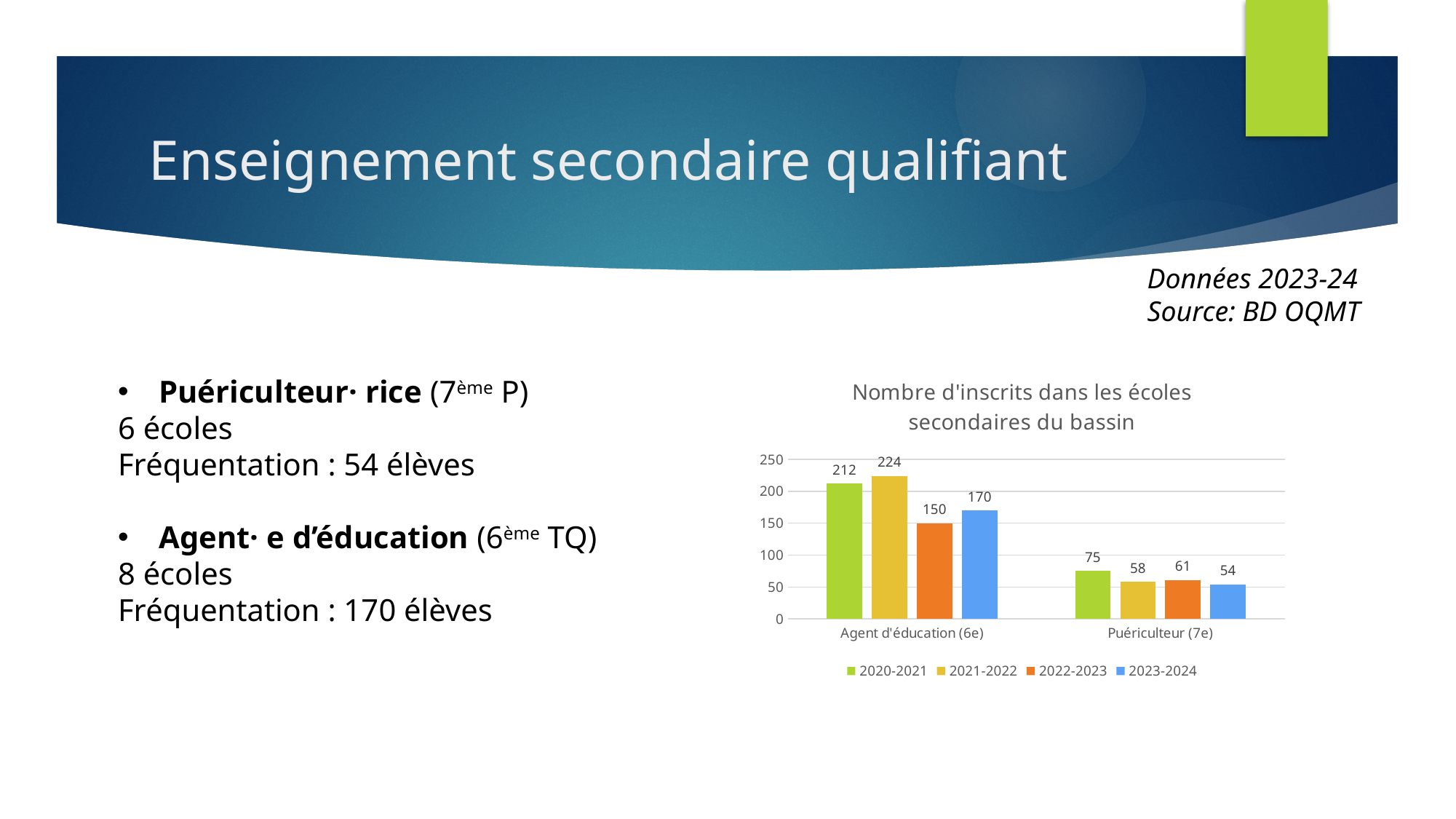
How many categories are shown on the x axis? 2 What is the difference between the 2021-2022 and 2022-2023 values for Agent d'éducation (6e)? 74 What is the value for Puériculteur (7e) in 2023-2024? 54 What is the value for Agent d'éducation (6e) in 2020-2021? 212 Which is larger for Puériculteur (7e): the 2021-2022 value or the 2022-2023 value? 2022-2023 Which year has the highest value for Agent d'éducation (6e)? 2021-2022 What kind of chart is shown on the slide? bar chart Which year has the lowest value for Puériculteur (7e)? 2023-2024 Is the value for Agent d'éducation (6e) in 2023-2024 greater or less than 150? greater How many series does the legend list? 4 What is the value for Agent d'éducation (6e) in 2022-2023? 150 What is the title of the chart? Nombre d'inscrits dans les écoles secondaires du bassin